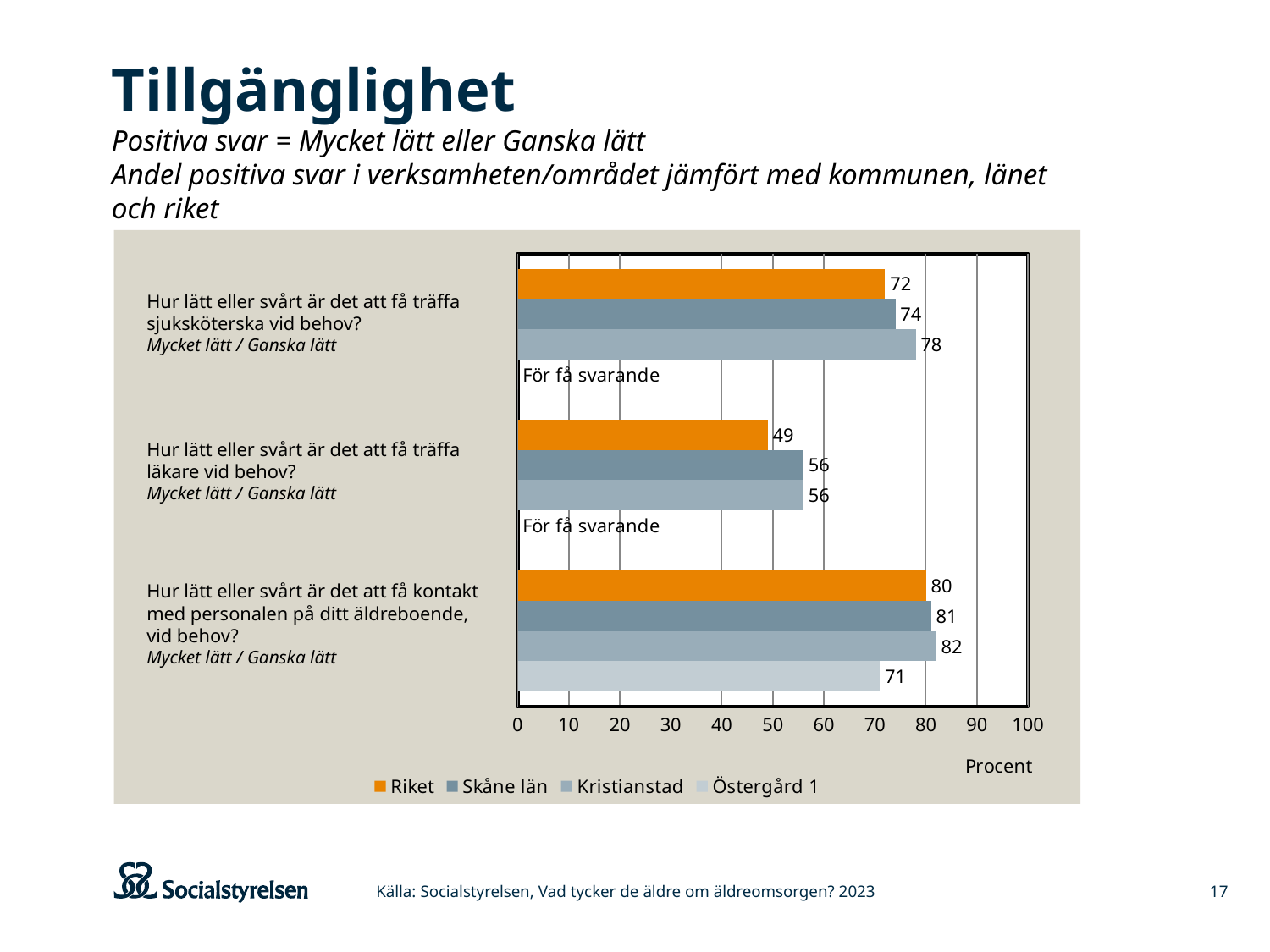
What is the value for Kristianstad for the question about meeting a nurse when needed ("Hur lätt eller svårt är det att få träffa sjuksköterska vid behov?")? 78 Which series has the lowest value for the question about getting in contact with staff at the elderly home? Östergård 1 What kind of chart is shown on the slide? bar chart How many series does the legend list? 4 What is the difference between Skåne län and Riket for the question about meeting a doctor when needed? 7 What is the value for Riket for the question about meeting a doctor when needed ("Hur lätt eller svårt är det att få träffa läkare vid behov?")? 49 What is the value for Riket for the question about getting in contact with staff at the elderly home ("Hur lätt eller svårt är det att få kontakt med personalen på ditt äldreboende, vid behov?")? 80 What is the value for Östergård 1 for the question about getting in contact with staff at the elderly home? 71 What is shown for Östergård 1 for the question about meeting a nurse when needed? För få svarande Which series has the highest value for the question about meeting a nurse when needed? Kristianstad What is the label on the x axis of the chart? Procent Which is larger for the question about meeting a nurse when needed: Riket or Skåne län? Skåne län